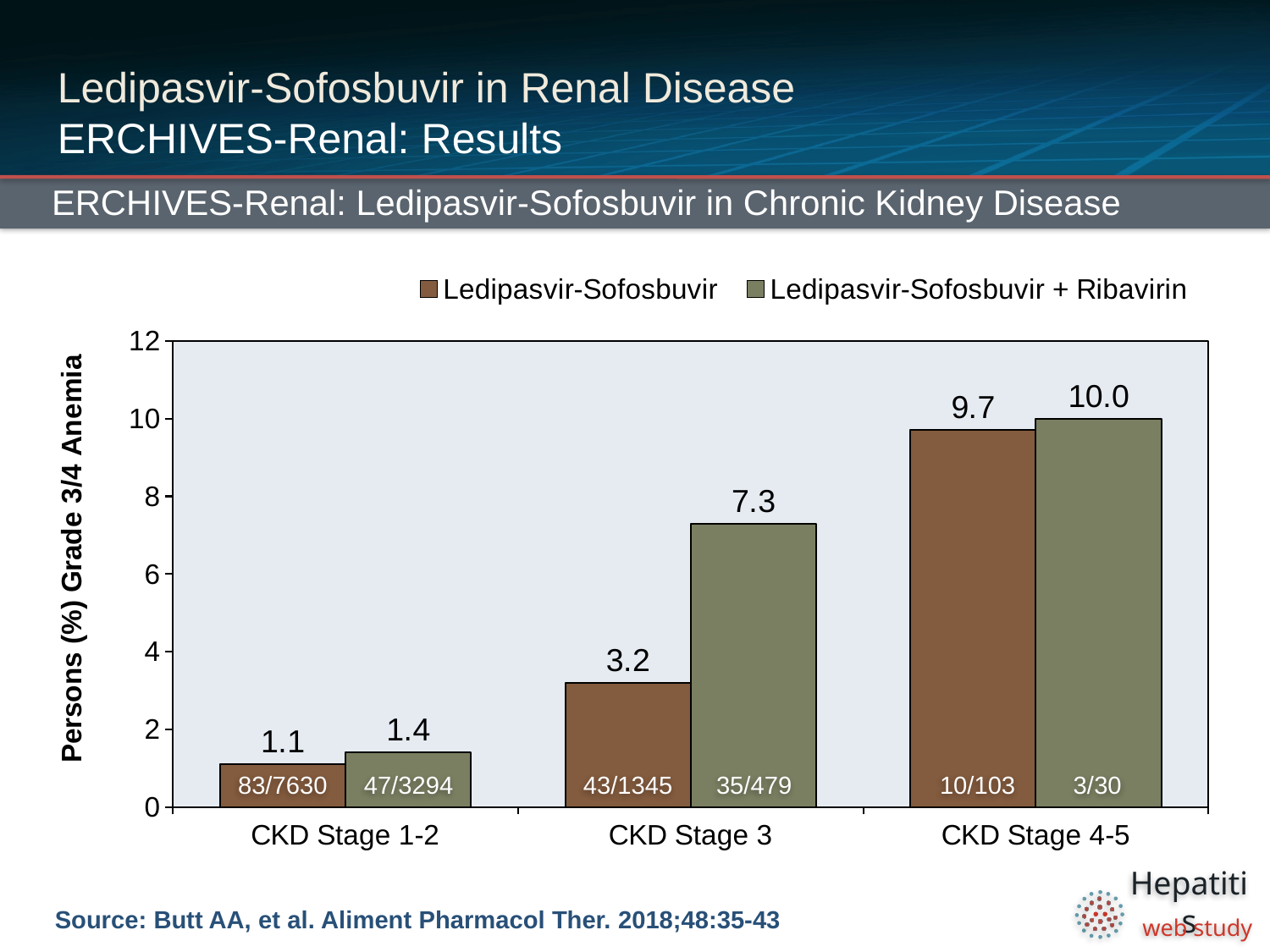
What is the value for Ledipasvir-Sofosbuvir in CKD Stage 3? 3.2 What is the value for Ledipasvir-Sofosbuvir + Ribavirin in CKD Stage 4-5? 10.0 In CKD Stage 4-5, which is larger: Ledipasvir-Sofosbuvir or Ledipasvir-Sofosbuvir + Ribavirin? Ledipasvir-Sofosbuvir + Ribavirin What is the difference between the Ledipasvir-Sofosbuvir + Ribavirin and Ledipasvir-Sofosbuvir values in CKD Stage 3? 4.1 What is the value for Ledipasvir-Sofosbuvir + Ribavirin in CKD Stage 1-2? 1.4 What is the label of the y axis? Persons (%) Grade 3/4 Anemia Which CKD stage has the highest value for Ledipasvir-Sofosbuvir? CKD Stage 4-5 How many series does the legend list? 2 Which CKD stage has the lowest value for Ledipasvir-Sofosbuvir + Ribavirin? CKD Stage 1-2 What kind of chart is shown on the slide? Bar chart Do the Ledipasvir-Sofosbuvir values rise or fall from CKD Stage 1-2 to CKD Stage 4-5? Rise How many CKD stage categories are shown on the x axis? 3